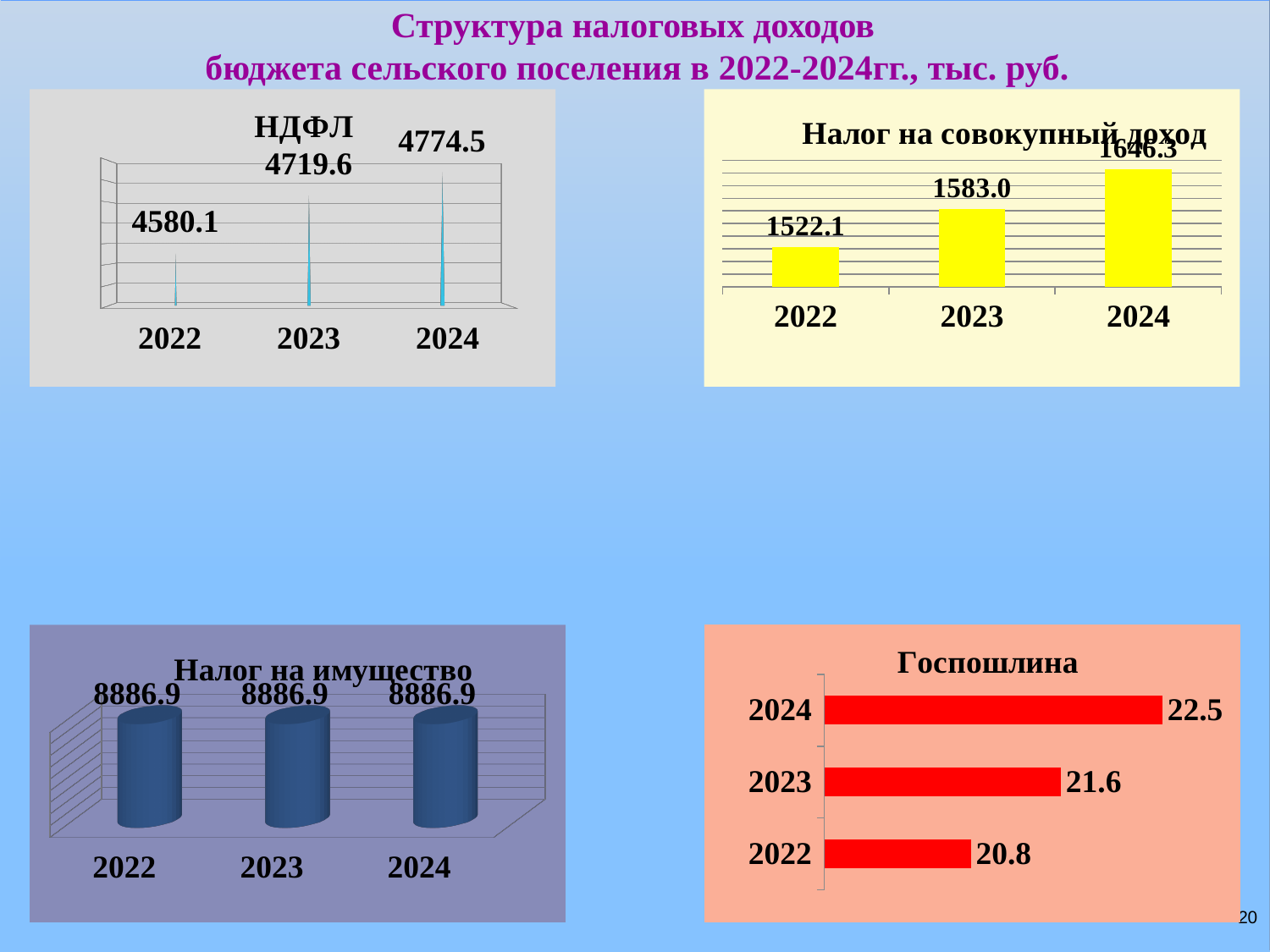
In the Налог на совокупный доход chart, which year has the highest value? 2024 In the НДФЛ chart, what is the difference between the 2023 and 2022 values? 139.5 In the Налог на имущество chart, what is the value for 2022? 8886.9 In the Госпошлина chart, what is the difference between the 2024 and 2022 values? 1.7 In the Госпошлина chart, which is larger, the value for 2024 or the value for 2022? 2024 In the НДФЛ chart, which year has the lowest value? 2022 In the Налог на совокупный доход chart, what is the value for 2023? 1583.0 How many years are shown in the Налог на имущество chart? 3 What kind of chart is the Госпошлина chart? bar chart In the Госпошлина chart, what is the value for 2023? 21.6 In the Налог на совокупный доход chart, do the values rise or fall from 2022 to 2024? rise In the НДФЛ chart, what is the value for 2024? 4774.5